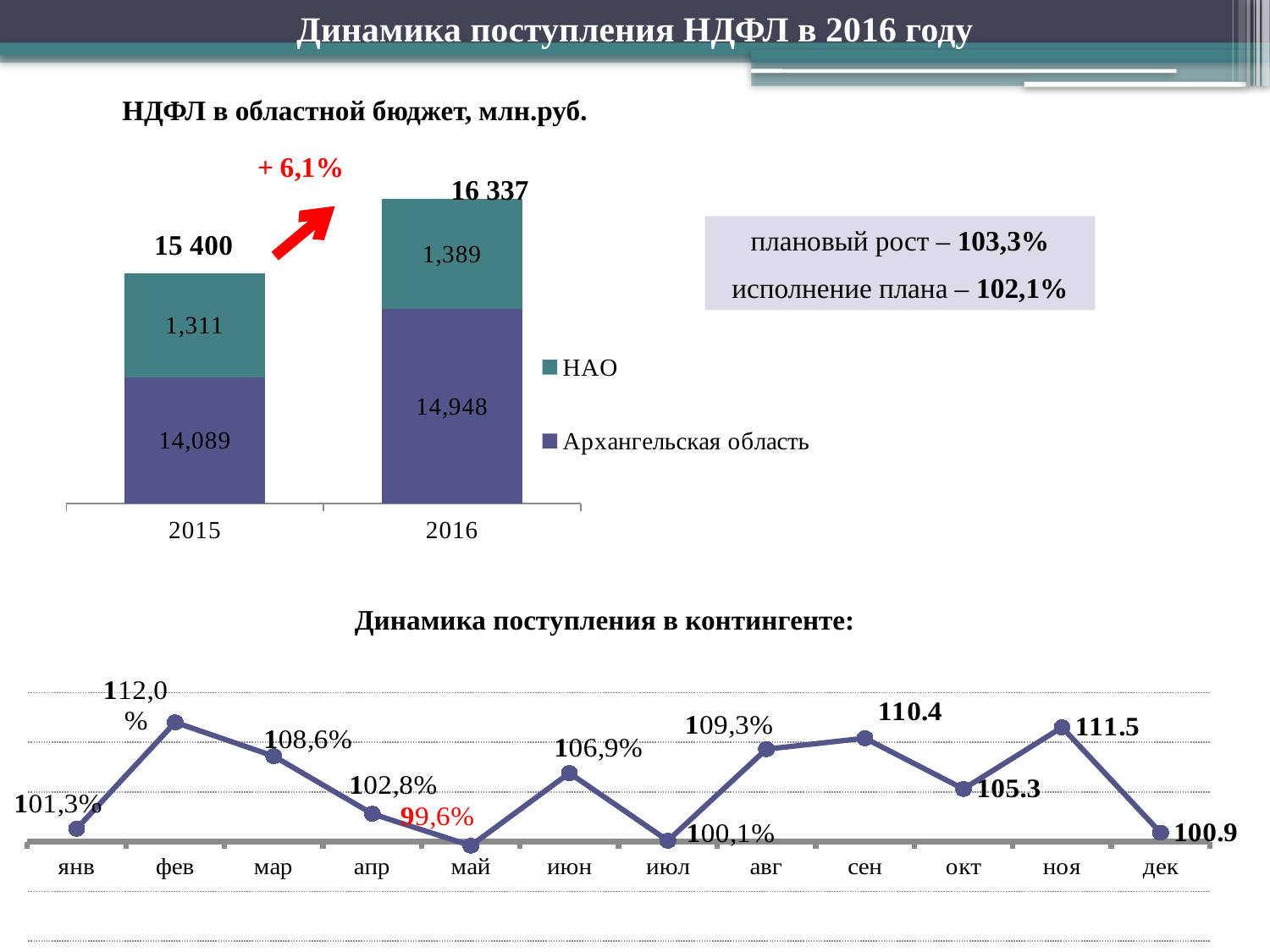
In the bottom chart 'Динамика поступления в контингенте', which is larger, the value for сен or the value for окт? сен In the top chart 'НДФЛ в областной бюджет, млн.руб.', what kind of chart is it? Stacked bar chart In the bottom chart 'Динамика поступления в контингенте', what kind of chart is it? Line chart In the top chart 'НДФЛ в областной бюджет, млн.руб.', what is the value for Архангельская область in 2016? 14,948 In the top chart 'НДФЛ в областной бюджет, млн.руб.', how many series does the legend list? 2 In the top chart 'НДФЛ в областной бюджет, млн.руб.', what is the value for НАО in 2015? 1,311 In the bottom chart 'Динамика поступления в контингенте', which month has the lowest value? май In the bottom chart 'Динамика поступления в контингенте', how many months are plotted? 12 In the bottom chart 'Динамика поступления в контингенте', what is the value for фев? 112,0% In the top chart 'НДФЛ в областной бюджет, млн.руб.', what is the difference between the НАО values for 2016 and 2015? 78 In the bottom chart 'Динамика поступления в контингенте', which month has the highest value? фев In the top chart 'НДФЛ в областной бюджет, млн.руб.', what is the total of the stacked bar for 2016? 16 337